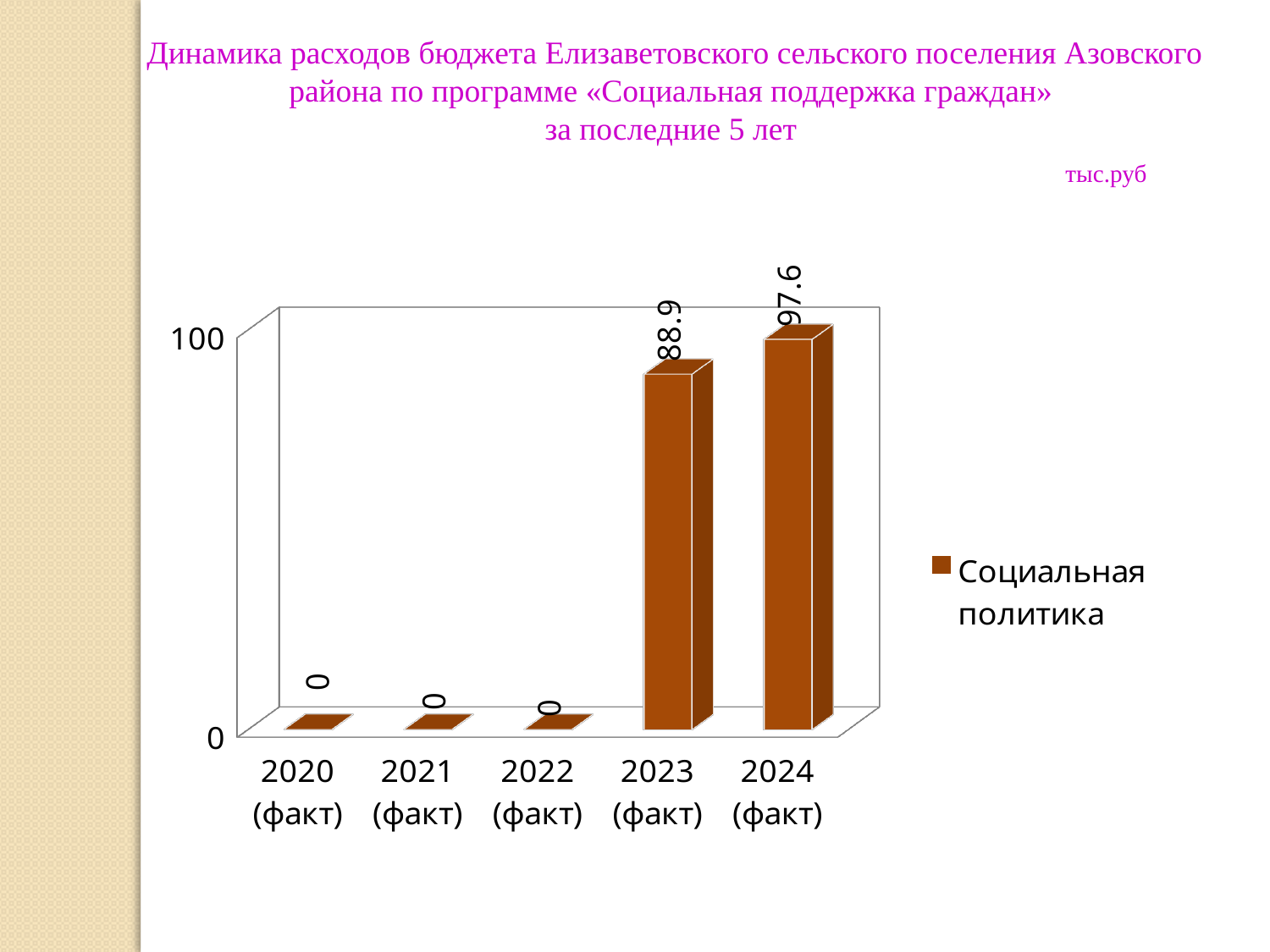
What is the difference between the values for 2024 (факт) and 2023 (факт)? 8.7 Which is larger, the value for 2023 (факт) or 2024 (факт)? 2024 (факт) What is the value for 2021 (факт)? 0 What is the value for 2024 (факт)? 97.6 How many years are shown on the x axis? 5 What is the value for 2023 (факт)? 88.9 What kind of chart is shown on the slide? bar chart Which year has the highest value? 2024 (факт) What series name is shown in the legend? Социальная политика How many series does the legend list? 1 Do the values rise or fall from 2022 (факт) to 2024 (факт)? rise Is the value for 2024 (факт) greater or less than 100? less